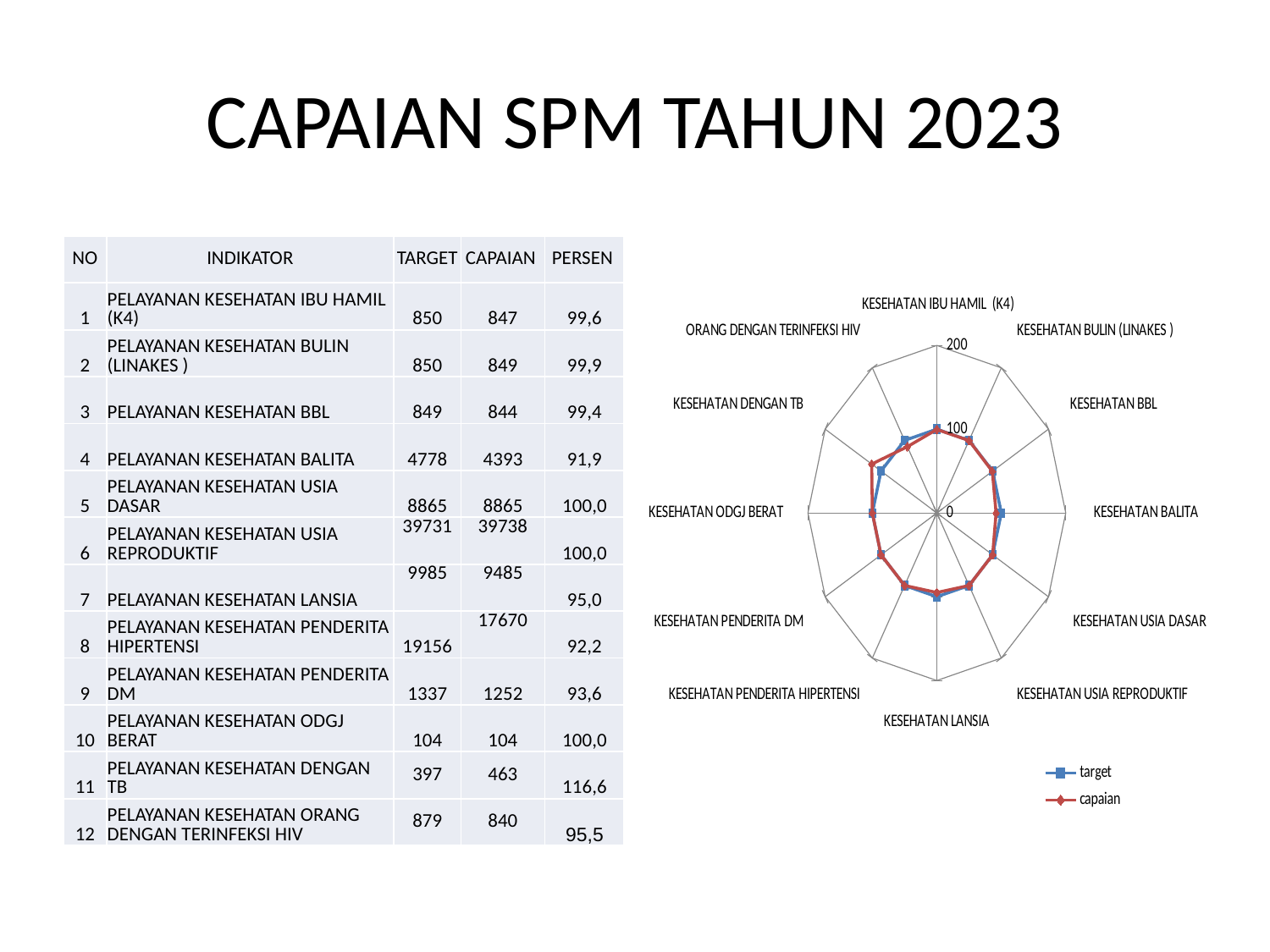
How many series does the legend of the radar chart list? 2 What are the two series named in the legend of the radar chart? target and capaian Which colour is used for the capaian series in the radar chart? red How many categories (axes) does the radar chart have? 12 Is the capaian value for KESEHATAN IBU HAMIL (K4) in the radar chart greater or less than 0? greater Is the target value for KESEHATAN BALITA in the radar chart greater or less than 200? less Is the capaian value for KESEHATAN LANSIA in the radar chart greater or less than 200? less What is the highest tick value shown on the radar chart's axis? 200 What kind of chart is shown on the slide? radar chart